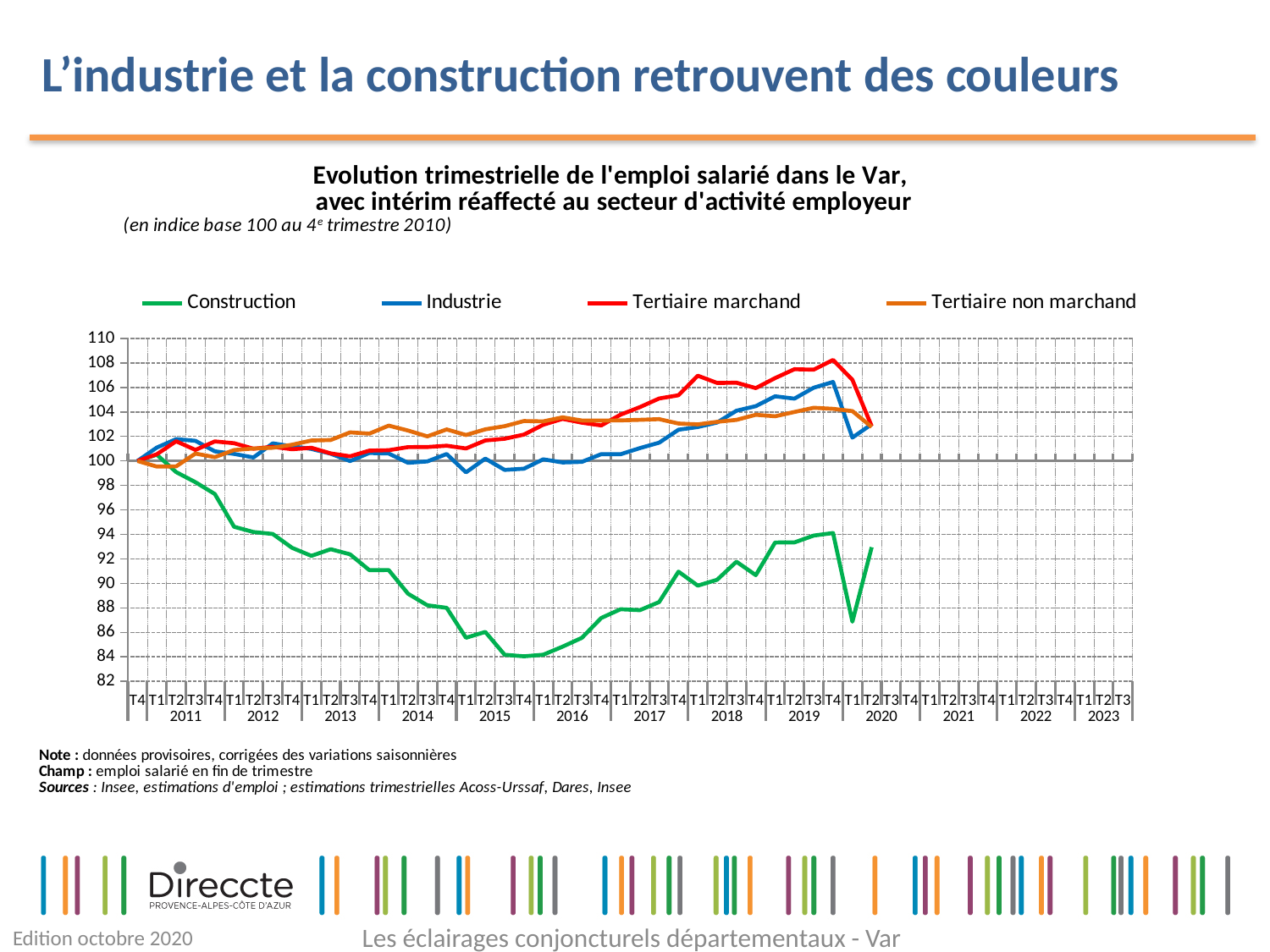
What is the index value of all four series at T4 2010, the base period? 100 Is the value for Construction at T2 2020 greater or less than 90? greater Which series is plotted in green? Construction At T4 2019, which is larger: Tertiaire marchand or Construction? Tertiaire marchand What kind of chart is shown on the slide? line chart Is the value for Industrie at T4 2019 greater or less than 104? greater Does the Construction series rise or fall between 2011 and 2015? fall Is the value for Construction at T1 2020 greater or less than 90? less How many series does the legend list? 4 Which series has the lowest values over the whole period from 2011 to 2020? Construction Which series has the highest value at T4 2019? Tertiaire marchand